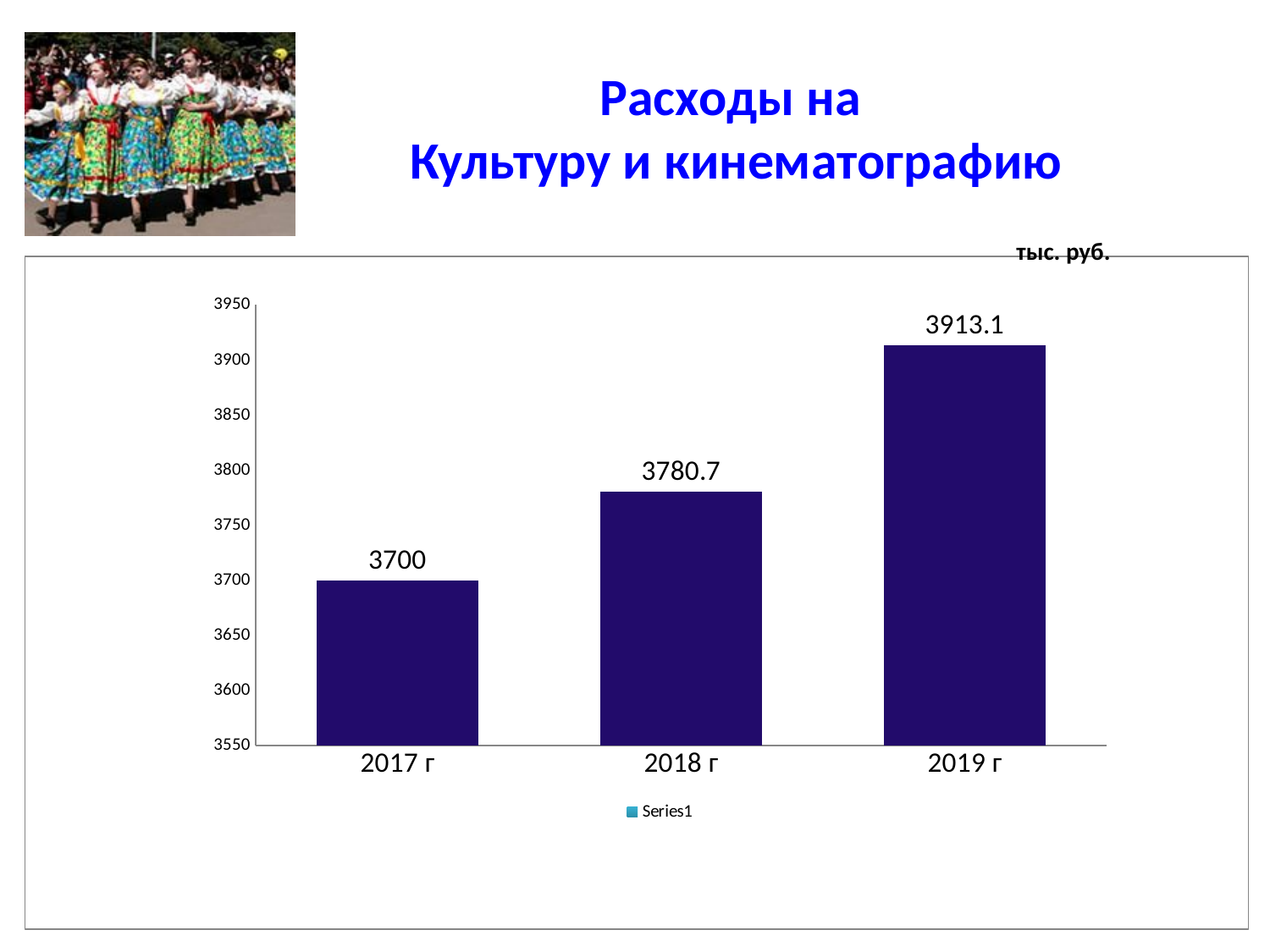
Which is larger, the value for 2017 г or the value for 2018 г? 2018 г What kind of chart is shown on the slide? bar chart Do the values rise or fall from 2017 г to 2019 г? rise Which year has the lowest value? 2017 г How many years are shown on the chart? 3 What is the difference between the values for 2018 г and 2017 г? 80.7 What is the difference between the values for 2019 г and 2018 г? 132.4 What is the value for 2017 г? 3700 Is the value for 2019 г greater or less than 3900? greater What is the value for 2018 г? 3780.7 What is the value for 2019 г? 3913.1 Which year has the highest value? 2019 г